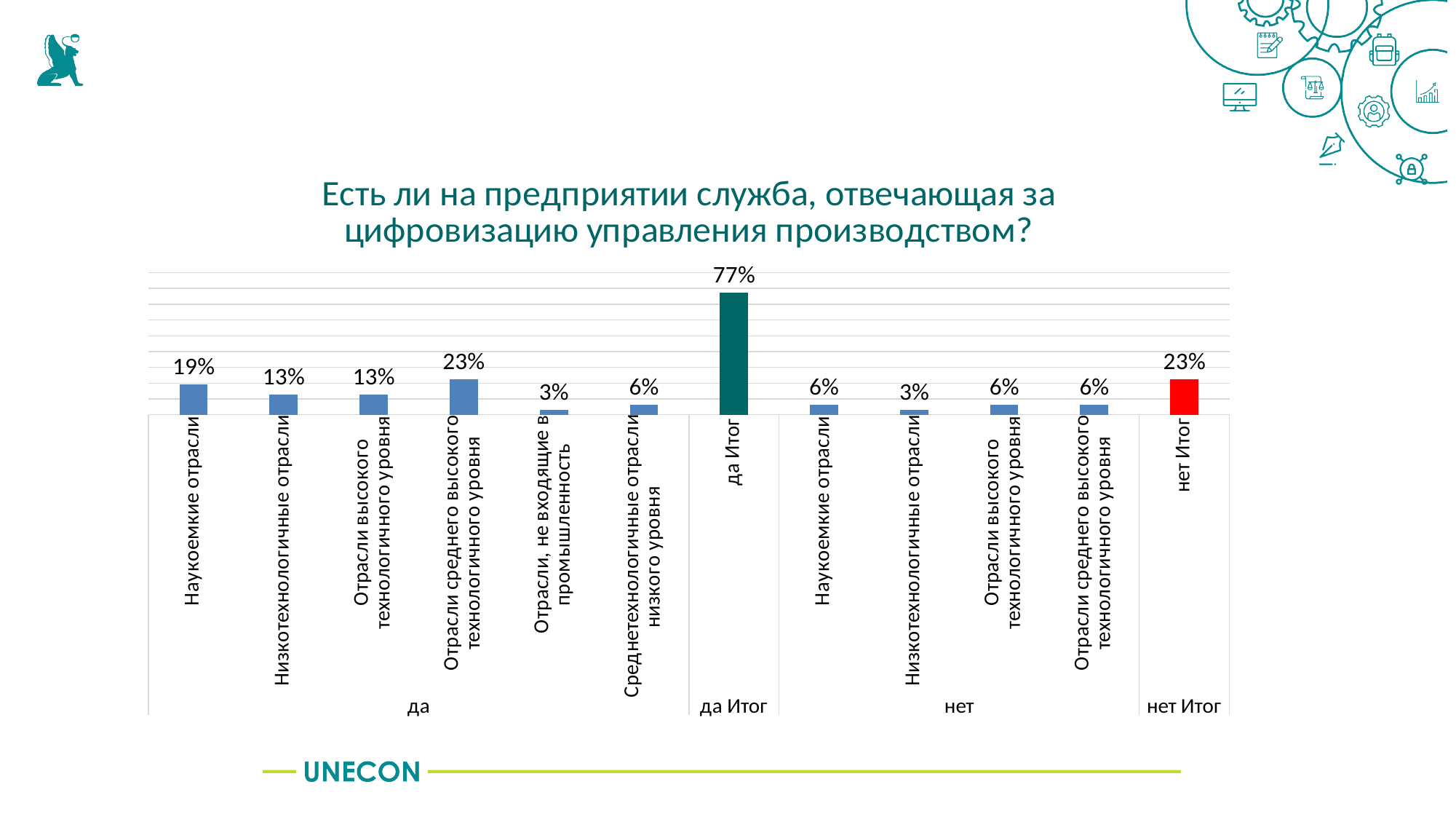
In the 'нет' group, what is the value for 'Низкотехнологичные отрасли'? 3% What colour is the 'нет Итог' bar? Red Which bar has the highest value on the chart? да Итог What is the difference between the 'да Итог' and 'нет Итог' values? 54% What type of chart is shown on the slide? Bar chart In the 'да' group, what is the value for 'Отрасли среднего высокого технологичного уровня'? 23% Within the 'да' group, which category has the lowest value? Отрасли, не входящие в промышленность Which is larger: 'Наукоемкие отрасли' in the 'да' group or 'Наукоемкие отрасли' in the 'нет' group? Наукоемкие отрасли in the 'да' group What is the value of the 'нет Итог' bar? 23% What is the value of the 'да Итог' bar? 77% In the 'да' group, what is the value for 'Наукоемкие отрасли'? 19% How many bars are plotted on the chart? 12